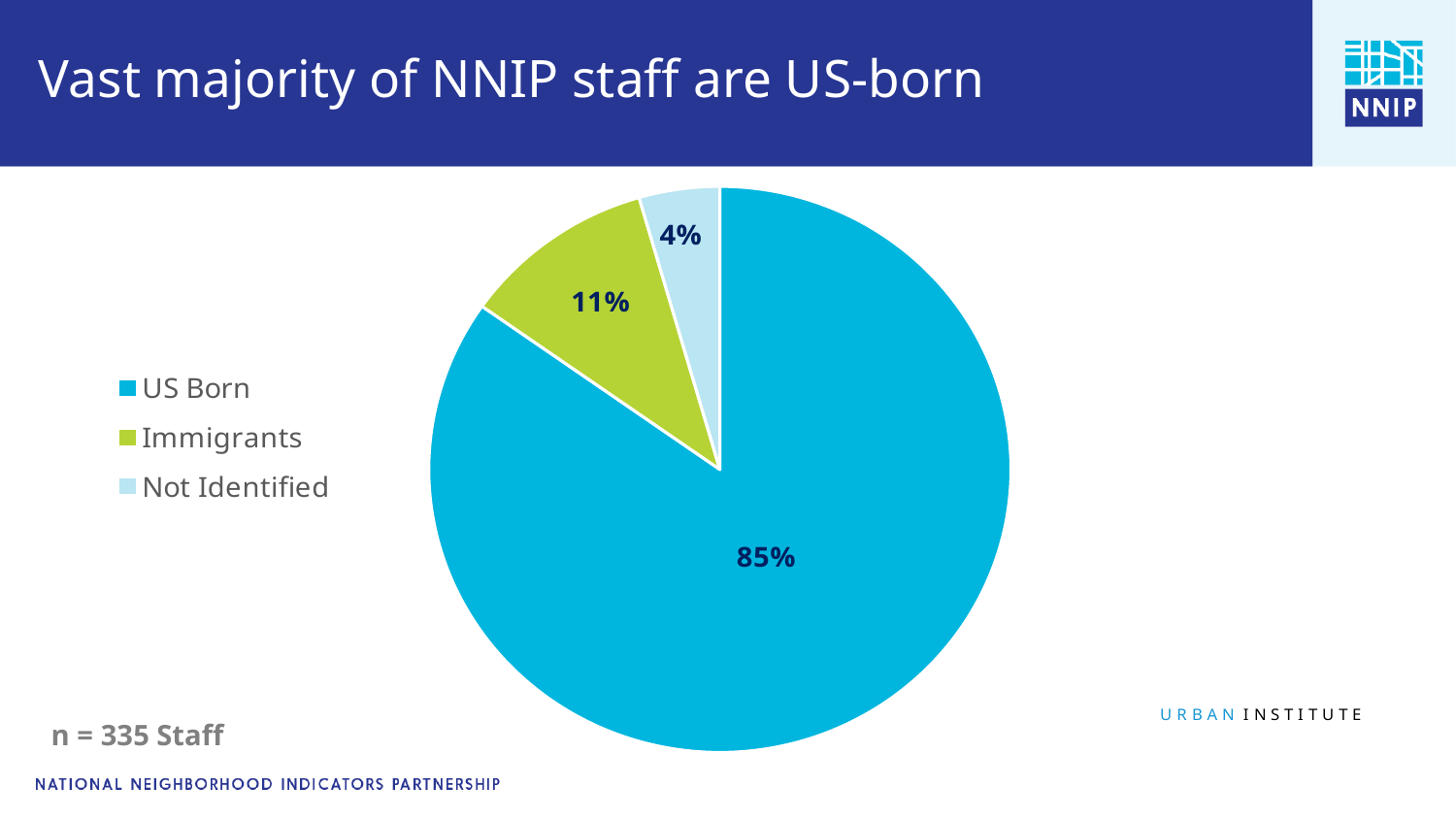
What is the difference in percentage points between the US Born and Immigrants slices? 74 Which category has the smallest slice of the pie? Not Identified What share of NNIP staff are Immigrants? 11% What share of NNIP staff are Not Identified? 4% How many staff does the chart represent, according to the note on the slide? 335 What share of NNIP staff are US Born? 85% Which is larger, the Immigrants slice or the Not Identified slice? Immigrants What is the difference in percentage points between the Immigrants and Not Identified slices? 7 What kind of chart is shown on the slide? Pie chart What is the title of the slide containing the chart? Vast majority of NNIP staff are US-born How many categories does the pie chart show? 3 Which category has the largest slice of the pie? US Born